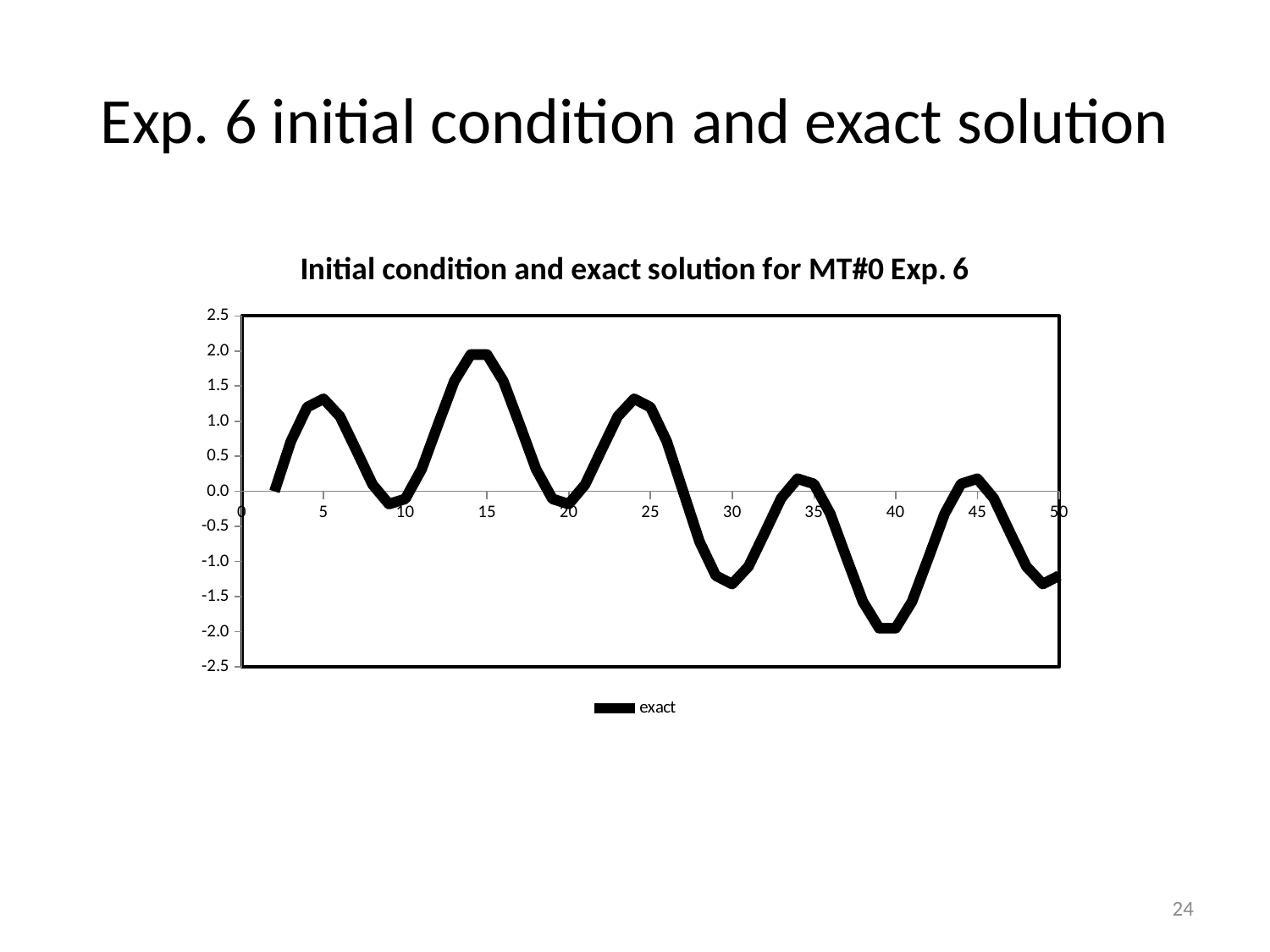
Is the value of the exact series at x = 15 greater or less than 1.5? greater Which is larger, the value of the exact series at x = 15 or at x = 5? x = 15 Is the value of the exact series at x = 40 greater or less than -1.5? less What is the title of the chart? Initial condition and exact solution for MT#0 Exp. 6 Is the value of the exact series at x = 30 greater or less than -1.0? less How many series does the legend list? 1 Near which x-axis tick does the exact series reach its highest value? 15 Near which x-axis tick does the exact series reach its lowest value? 40 What is the name of the series shown in the legend? exact What kind of chart is shown on the slide? line chart Does the exact series rise or fall between x = 15 and x = 20? fall